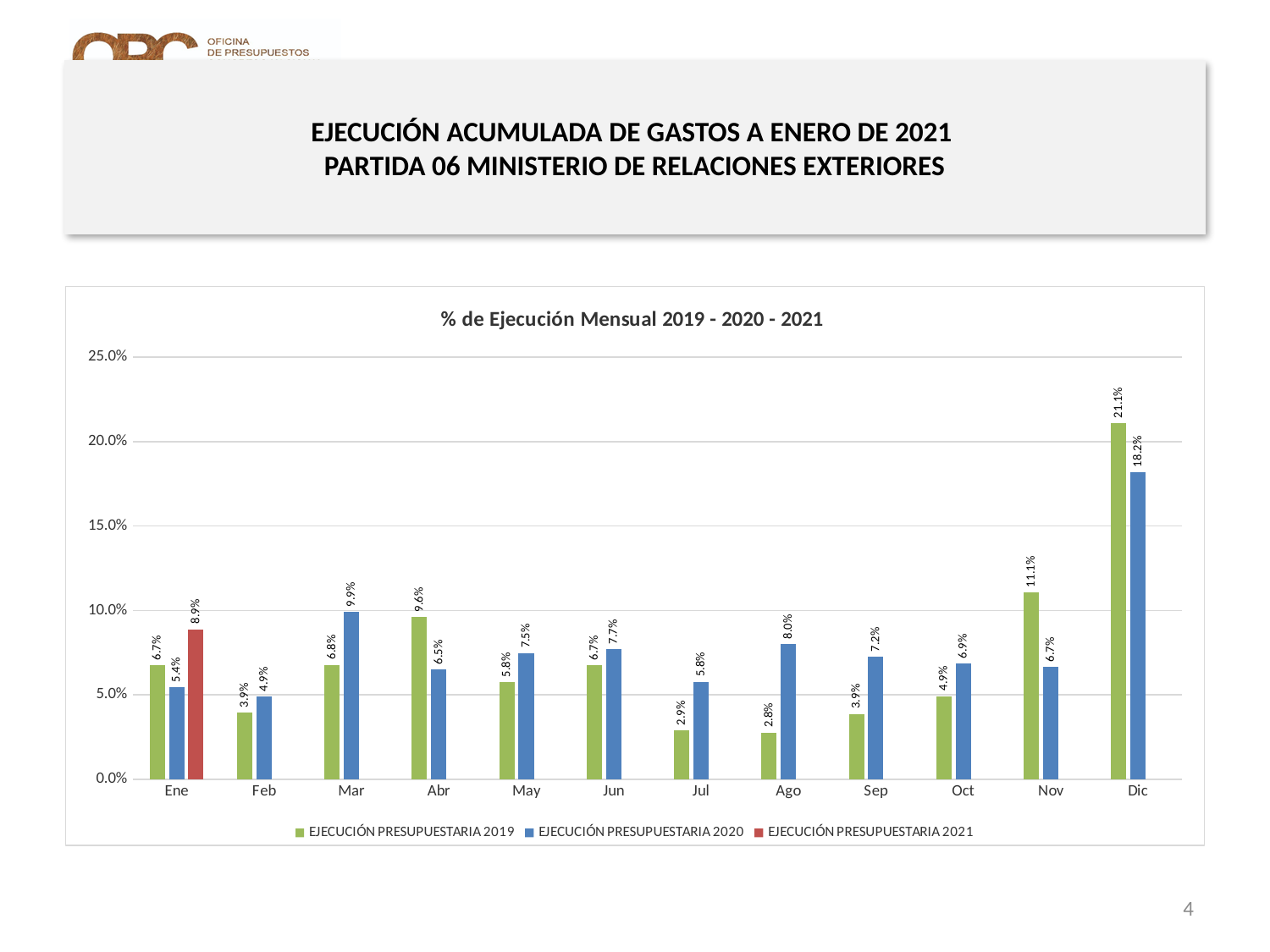
What is the value for EJECUCIÓN PRESUPUESTARIA 2019 in Nov? 11.1% Which month has the lowest value for EJECUCIÓN PRESUPUESTARIA 2019? Ago Is the value for EJECUCIÓN PRESUPUESTARIA 2020 in Dic greater or less than 15.0%? greater How many months are shown on the x axis? 12 What is the value for EJECUCIÓN PRESUPUESTARIA 2021 in Ene? 8.9% What is the value for EJECUCIÓN PRESUPUESTARIA 2020 in Mar? 9.9% What is the difference between the EJECUCIÓN PRESUPUESTARIA 2019 and EJECUCIÓN PRESUPUESTARIA 2020 values in Dic? 2.9% What kind of chart is shown on the slide? Bar chart Which month has the highest value for EJECUCIÓN PRESUPUESTARIA 2019? Dic How many series does the legend list? 3 Which month has the lowest value for EJECUCIÓN PRESUPUESTARIA 2020? Feb In Ago, which is larger: EJECUCIÓN PRESUPUESTARIA 2019 or EJECUCIÓN PRESUPUESTARIA 2020? EJECUCIÓN PRESUPUESTARIA 2020